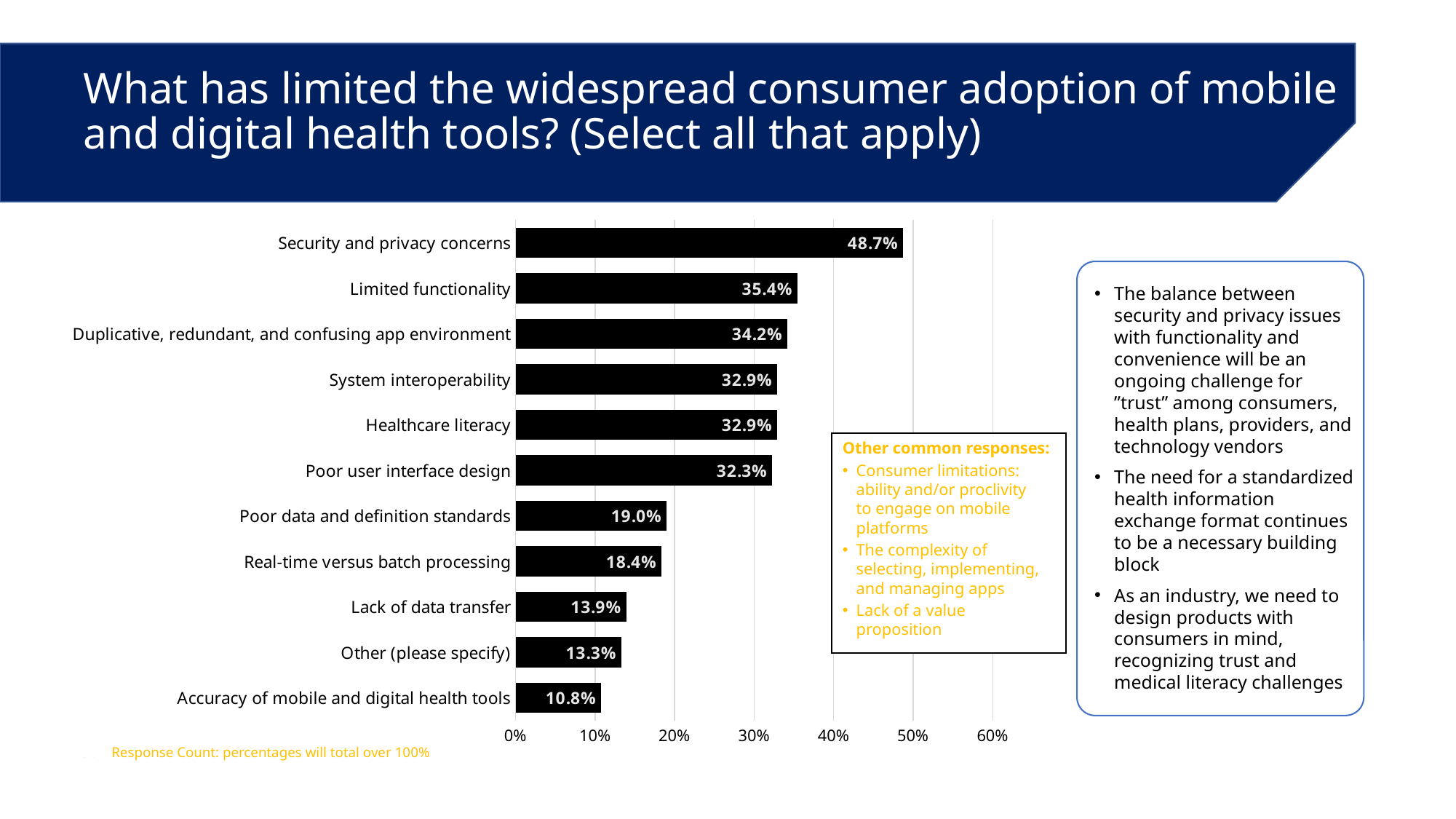
What type of chart is shown on the slide? Bar chart Which category has the lowest value in the chart? Accuracy of mobile and digital health tools What is the difference between the values for "Security and privacy concerns" and "Limited functionality"? 13.3% Is the value for "Poor data and definition standards" greater or less than 20%? less What is the value shown for "Poor user interface design"? 32.3% What is the difference between "Poor data and definition standards" and "Real-time versus batch processing"? 0.6% What percentage of respondents selected "Security and privacy concerns"? 48.7% What percentage is shown for "Lack of data transfer"? 13.9% How many categories are plotted in the bar chart? 11 Which category has the highest value in the chart? Security and privacy concerns What is the highest value labelled on the horizontal axis of the chart? 60% Which is larger: the value for "Limited functionality" or the value for "Duplicative, redundant, and confusing app environment"? Limited functionality